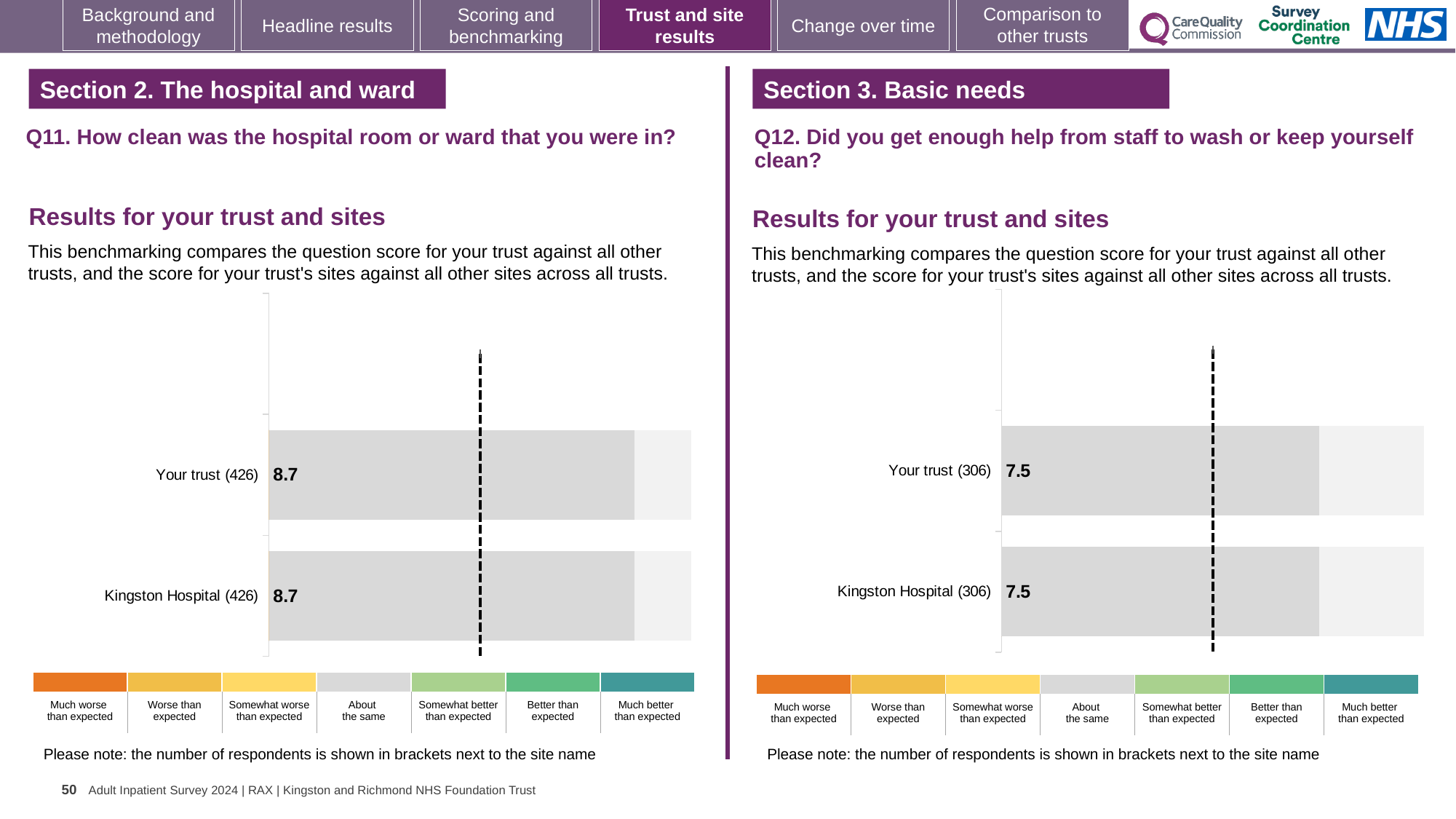
On the Q11 chart (left), what is the score for Your trust? 8.7 On the Q12 chart (right), what is the score for Your trust? 7.5 On the Q11 chart (left), what is the difference between the Your trust score and the Kingston Hospital score? 0 How many bars are plotted on the Q12 chart (right)? 2 On the Q12 chart (right), what is the difference between the Your trust score and the Kingston Hospital score? 0 Is the Your trust score on the Q11 chart (left) larger or smaller than the Your trust score on the Q12 chart (right)? Larger What kind of chart is the Q11 chart (left)? Bar chart On the Q12 chart (right), what is the score for Kingston Hospital? 7.5 On the Q11 chart (left), how many respondents are shown in brackets for Your trust? 426 How many bars are plotted on the Q11 chart (left)? 2 On the Q12 chart (right), how many respondents are shown in brackets for Kingston Hospital? 306 On the Q11 chart (left), what is the score for Kingston Hospital? 8.7